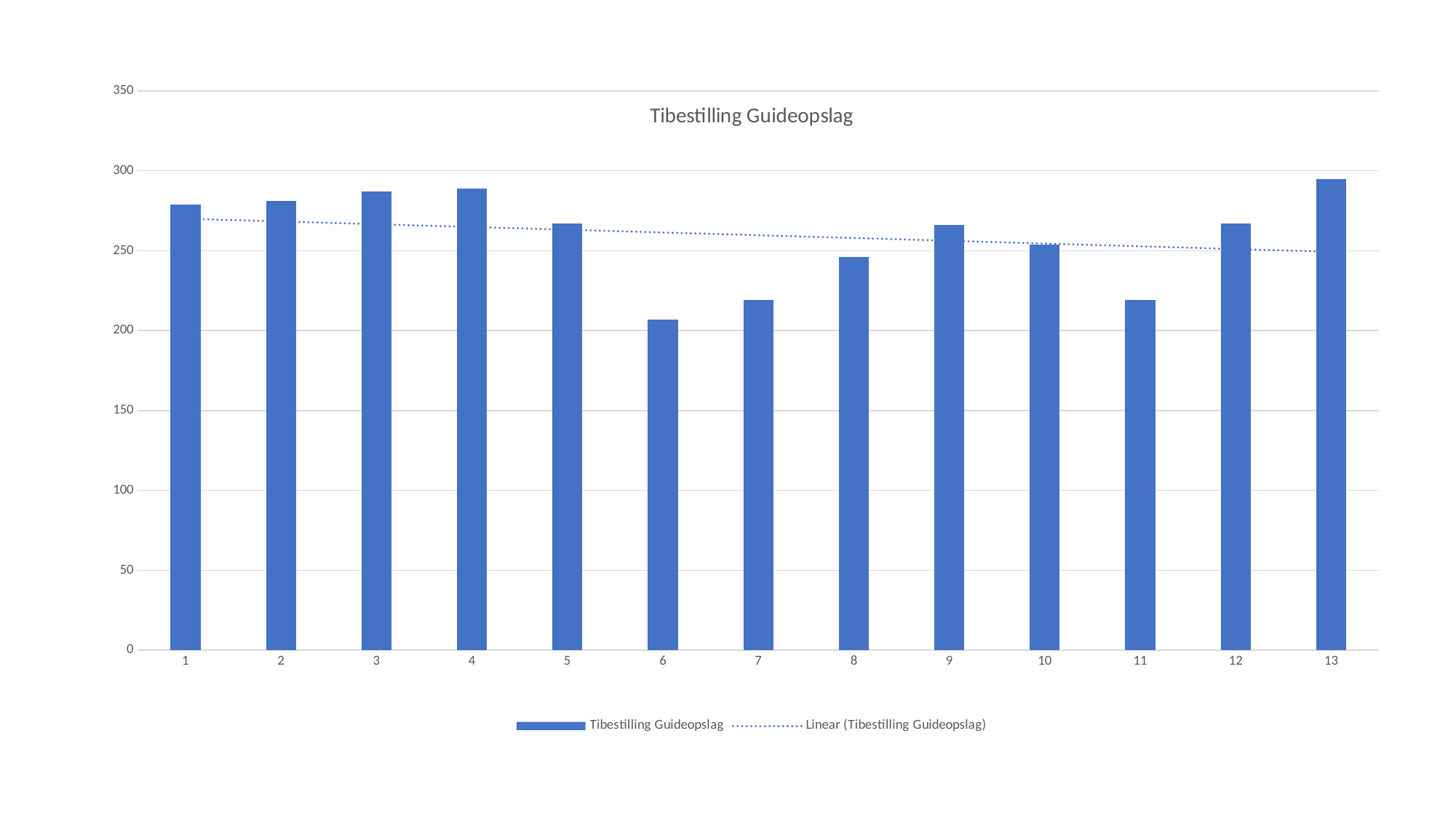
Which is larger, the value for category 1 or the value for category 5? category 1 Is the value for category 7 greater or less than 250? less Which category has the highest bar? 13 How many entries does the legend list? 2 How many categories are shown on the x axis? 13 Does the dotted linear trendline rise or fall from left to right? fall Which category has the lowest bar? 6 Is the value for category 3 greater or less than 250? greater What is the title of the chart? Tibestilling Guideopslag Is the value for category 13 greater or less than 250? greater What kind of chart is shown on the slide? bar chart